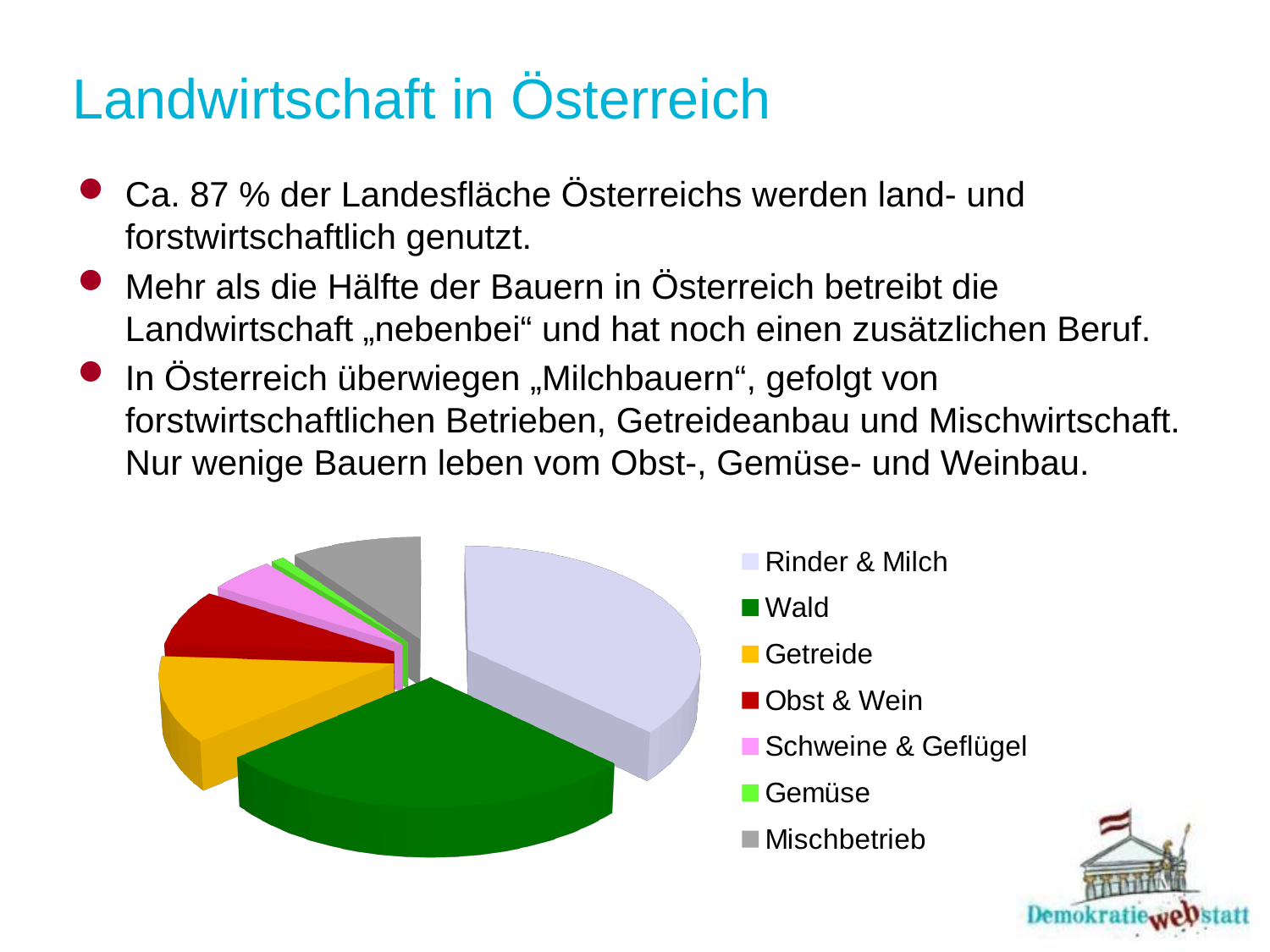
Which slice is larger in the pie chart, Wald or Schweine & Geflügel? Wald Which category is shown in yellow in the pie chart? Getreide What colour is the Wald slice in the pie chart? green Which slice is larger in the pie chart, Wald or Getreide? Wald Which category has the largest slice in the pie chart? Rinder & Milch Which category has the smallest slice in the pie chart? Gemüse How many categories does the pie chart's legend list? 7 Which slice is larger in the pie chart, Rinder & Milch or Mischbetrieb? Rinder & Milch What kind of chart is shown on the slide? pie chart Which category has the second-largest slice in the pie chart? Wald